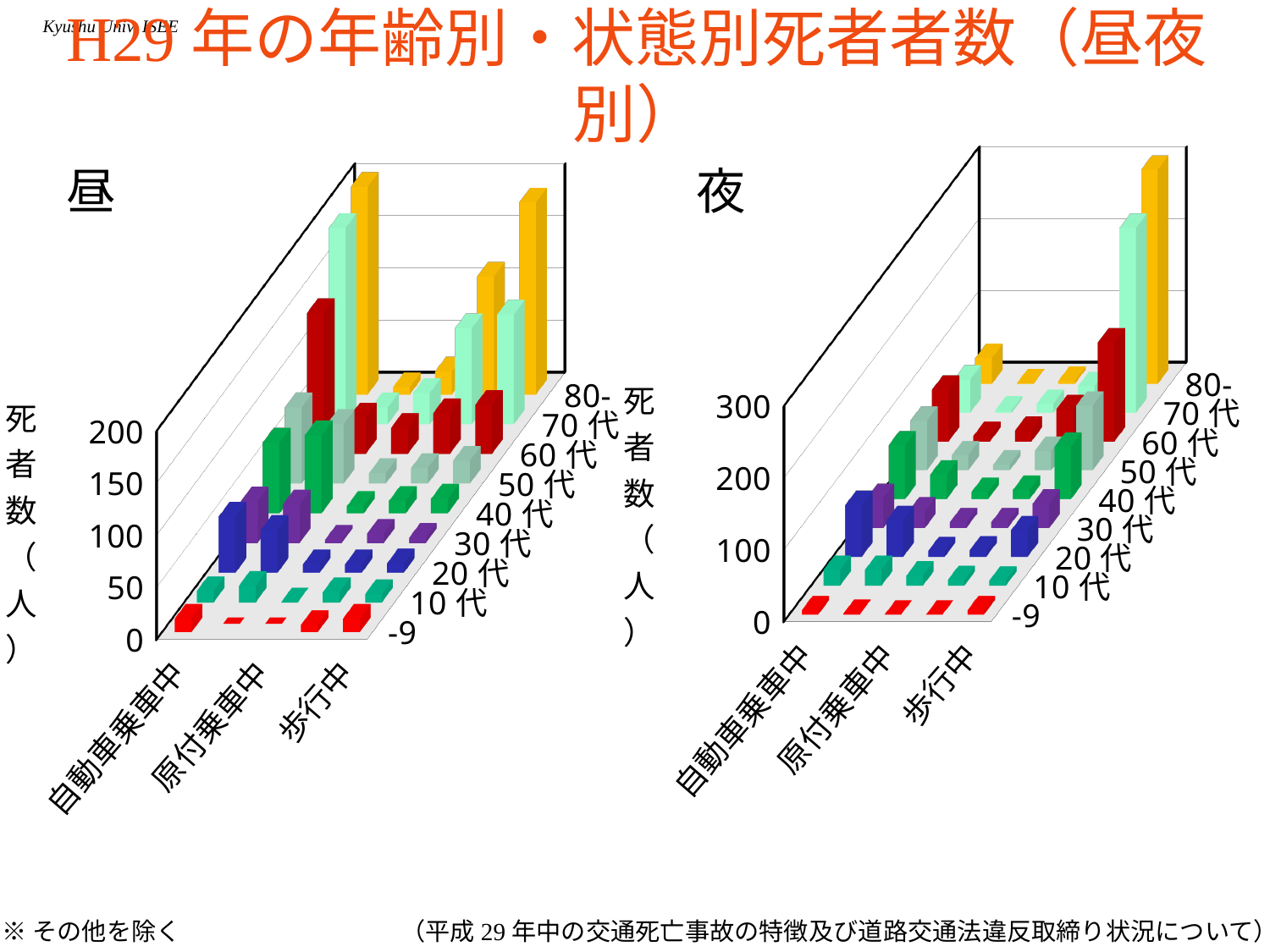
How many age groups are plotted in the 昼 chart? 9 In the 昼 chart, for the 80- age group, which is larger: 自動車乗車中 or 原付乗車中? 自動車乗車中 What is the label of the vertical axis on the 昼 chart? 死者数（人） In the 夜 chart, which category has the tallest bar for the 80- age group? 歩行中 In the 昼 chart, which category has the tallest bar for the 80- age group? 自動車乗車中 In the 夜 chart, for the 80- age group, which is larger: 歩行中 or 自動車乗車中? 歩行中 What kind of chart is the 昼 chart? bar chart What is the title of the slide? H29 年の年齢別・状態別死者者数（昼夜別） In the 夜 chart, for the 20代 age group, which is larger: 自動車乗車中 or 原付乗車中? 自動車乗車中